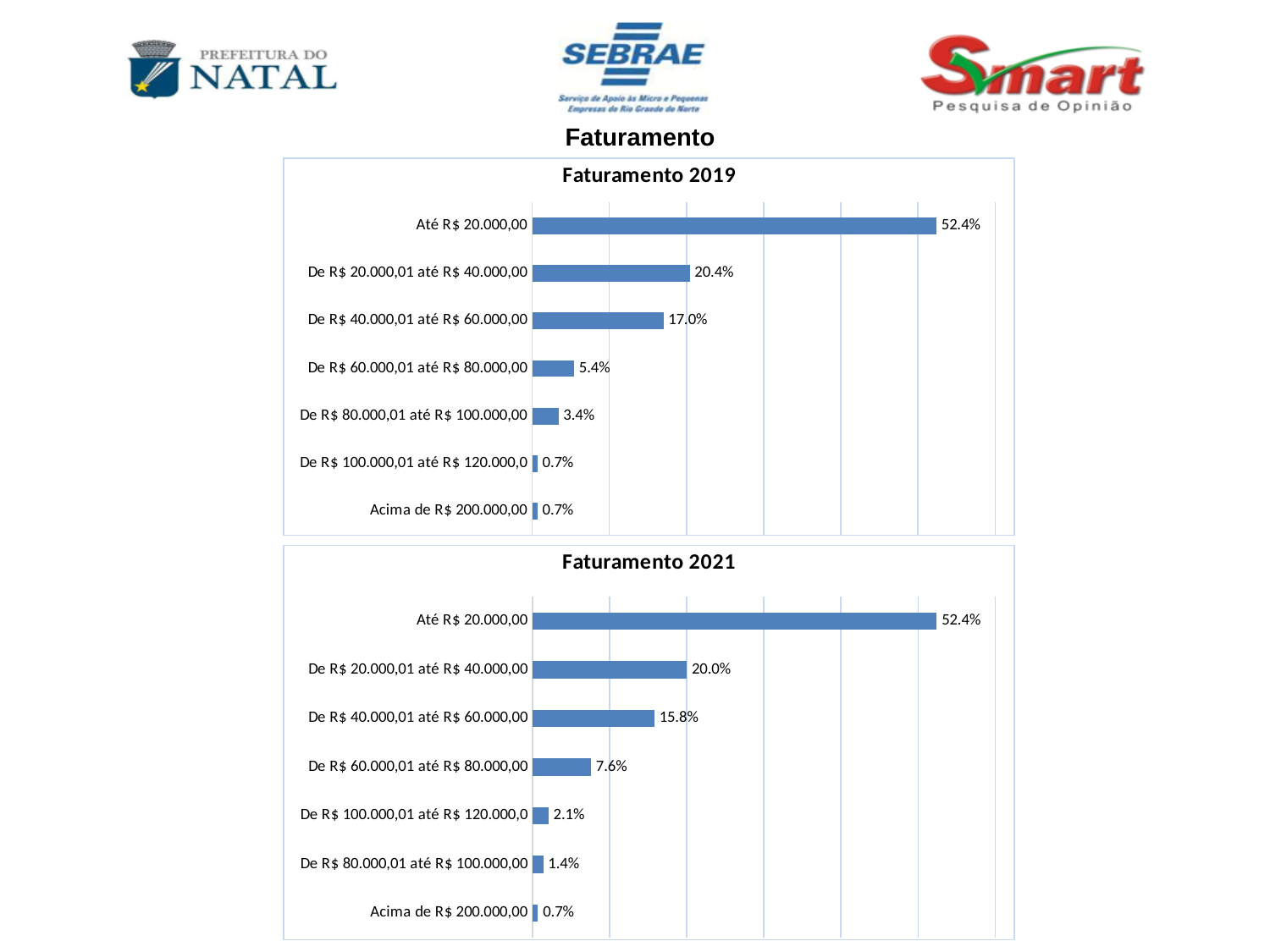
In the Faturamento 2019 chart, which category has the highest value? Até R$ 20.000,00 In the Faturamento 2019 chart, what is the value for 'Até R$ 20.000,00'? 52.4% Which is larger: 'De R$ 60.000,01 até R$ 80.000,00' in the Faturamento 2019 chart or in the Faturamento 2021 chart? Faturamento 2021 In the Faturamento 2019 chart, what is the value for 'De R$ 40.000,01 até R$ 60.000,00'? 17.0% In the Faturamento 2021 chart, which category has the lowest value? Acima de R$ 200.000,00 What type of chart is the Faturamento 2019 chart? Bar chart In the Faturamento 2021 chart, what is the difference between 'Até R$ 20.000,00' and 'De R$ 20.000,01 até R$ 40.000,00'? 32.4% In the Faturamento 2021 chart, what is the value for 'De R$ 80.000,01 até R$ 100.000,00'? 1.4% In the Faturamento 2019 chart, what is the difference between 'De R$ 20.000,01 até R$ 40.000,00' and 'De R$ 40.000,01 até R$ 60.000,00'? 3.4% How many categories are shown in the Faturamento 2021 chart? 7 In the Faturamento 2021 chart, what is the value for 'De R$ 60.000,01 até R$ 80.000,00'? 7.6% What is the title of the lower chart on the slide? Faturamento 2021